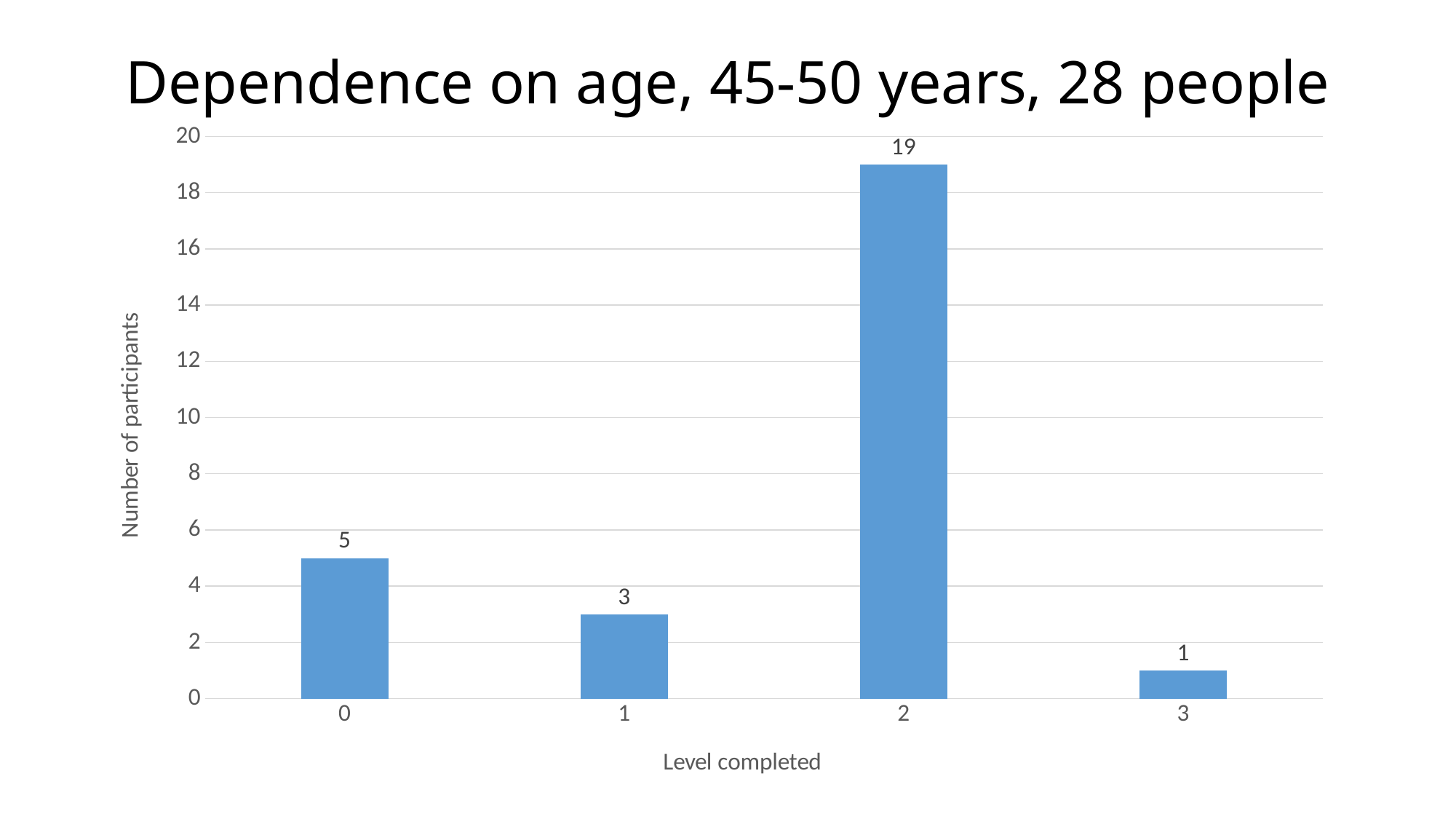
What is the difference in number of participants between level 2 and level 0? 14 How many level categories are shown on the x axis? 4 What kind of chart is shown on the slide? Bar chart What is the title of the chart? Dependence on age, 45-50 years, 28 people How many participants completed level 0? 5 Which level completed has the highest number of participants? 2 How many participants completed level 3? 1 Which has more participants, level 0 or level 1? Level 0 How many participants completed level 1? 3 Which level completed has the lowest number of participants? 3 How many participants completed level 2? 19 Is the number of participants for level 2 greater or less than 18? greater